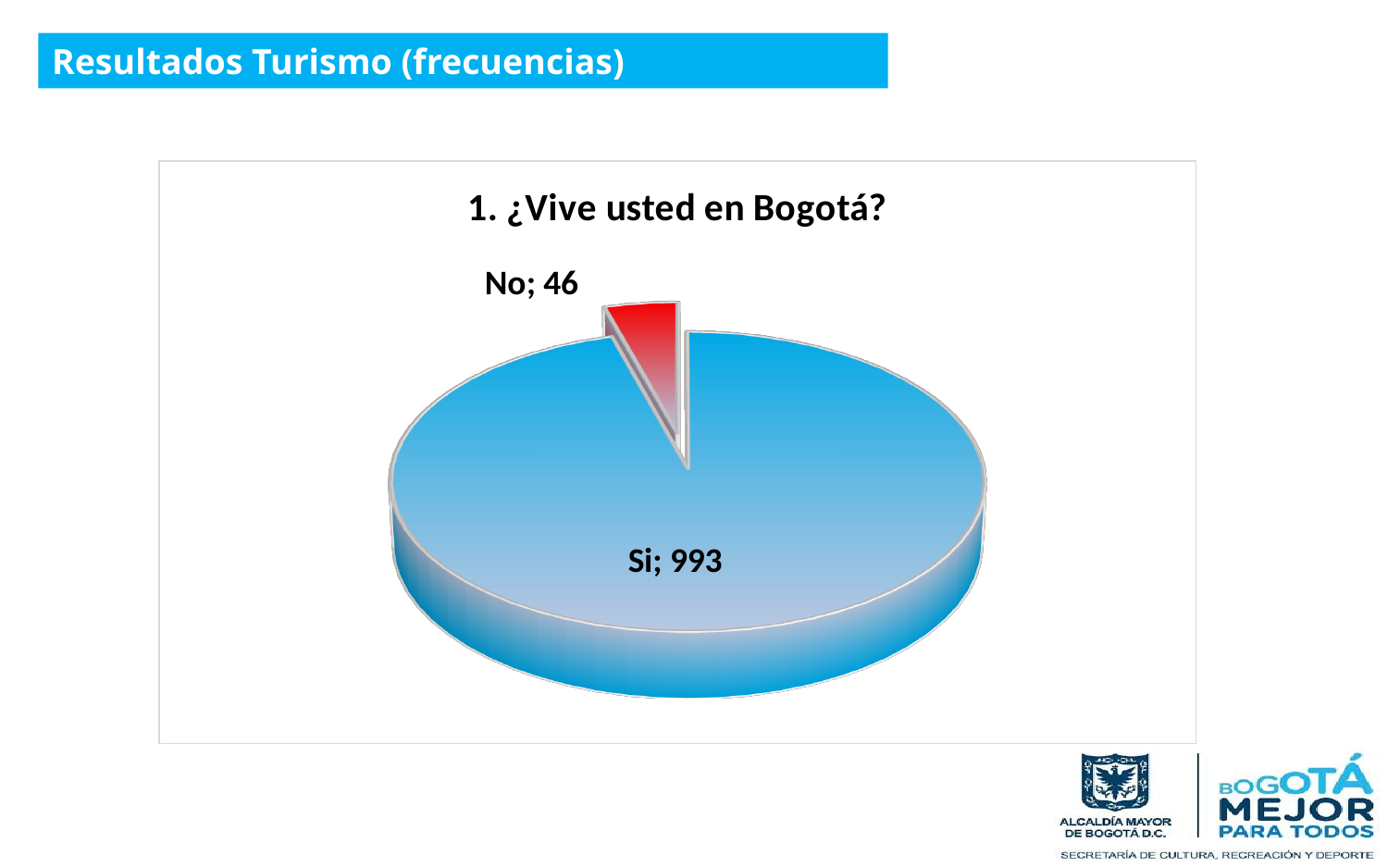
What kind of chart is shown on the slide? Pie chart What is the value for "Si" in the pie chart? 993 What is the title of the pie chart? 1. ¿Vive usted en Bogotá? How many categories (slices) does the pie chart have? 2 What is the total of all slices in the pie chart? 1039 What colour is the "No" slice in the pie chart? Red What is the difference between the values for "Si" and "No"? 947 Which category has the largest slice in the pie chart? Si Which is larger, the value for "Si" or the value for "No"? Si Which category has the smallest slice in the pie chart? No To the nearest whole percent, what share of the pie does "Si" represent? 96% What is the value for "No" in the pie chart? 46